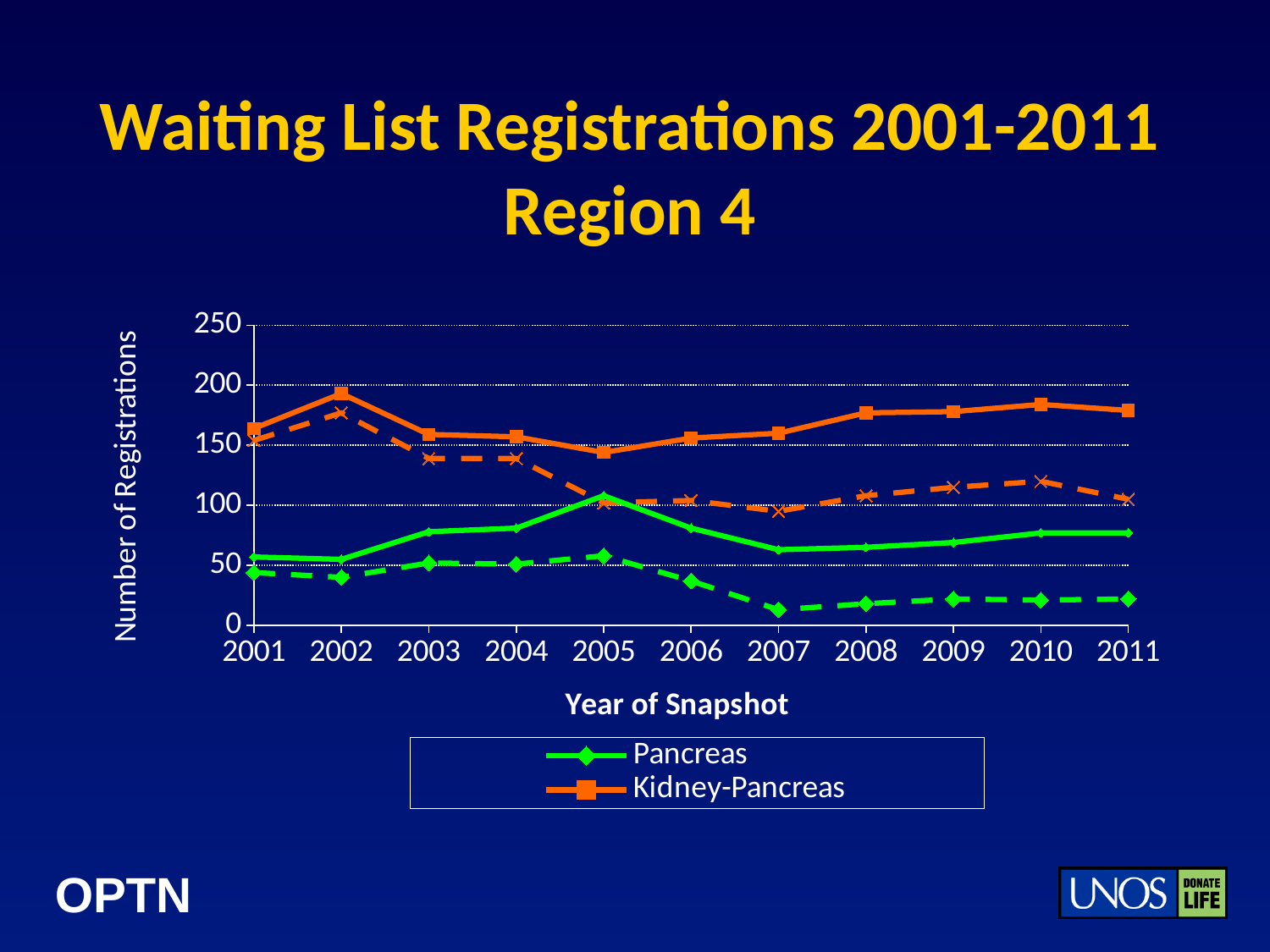
In which year is the Kidney-Pancreas series at its lowest? 2005 Is the Kidney-Pancreas value for 2002 greater or less than 150? greater What is the title of the x axis? Year of Snapshot Is the Pancreas value for 2005 greater or less than 100? greater How many years are plotted along the x axis? 11 Which series has the higher value in 2002, Pancreas or Kidney-Pancreas? Kidney-Pancreas Is the Kidney-Pancreas value for 2005 greater or less than 150? less What kind of chart is shown on the slide? line chart How many series does the legend list? 2 In which year is the Pancreas series at its highest? 2005 In which year is the Kidney-Pancreas series at its highest? 2002